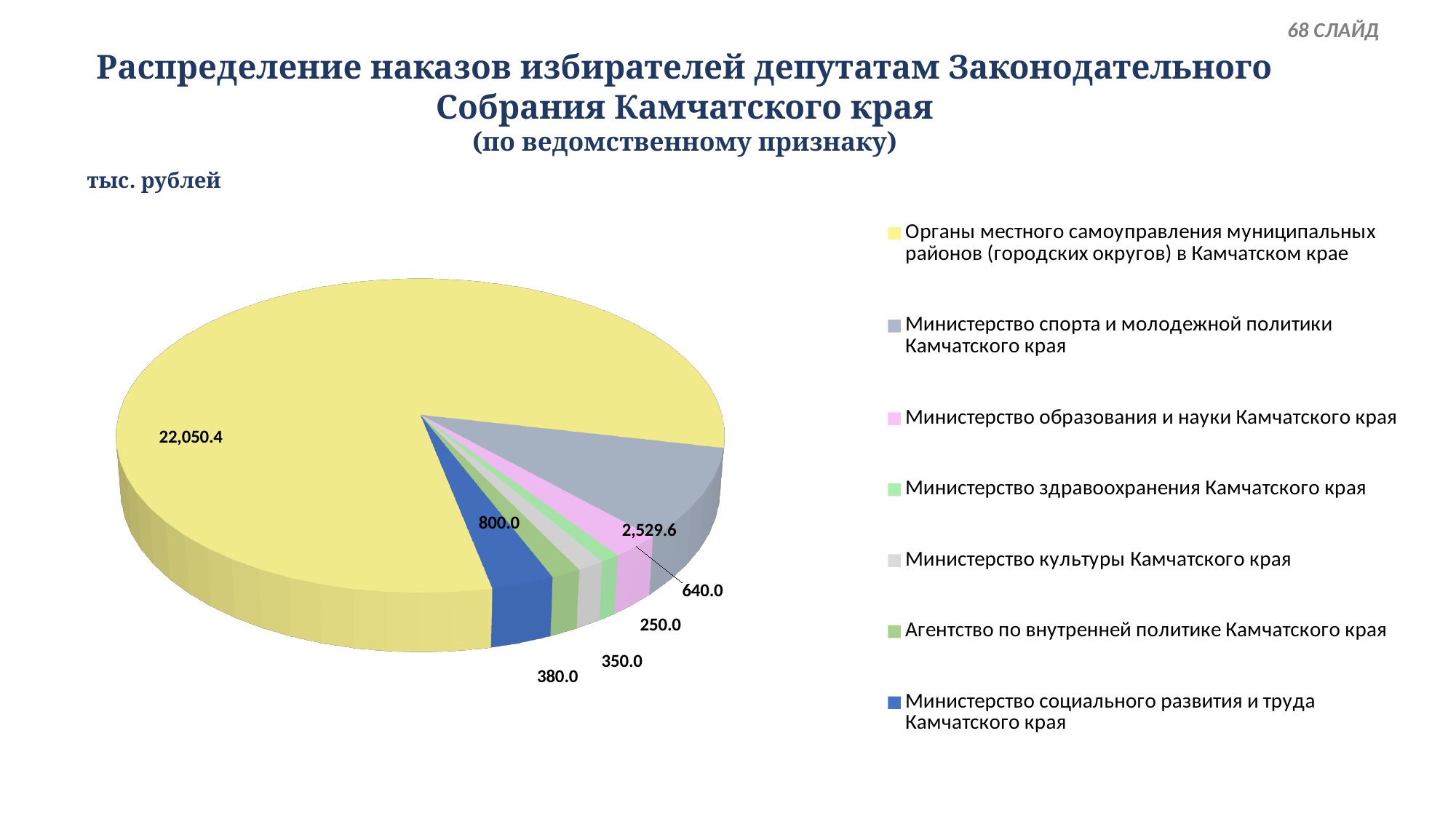
Which is larger: the value for Агентство по внутренней политике Камчатского края or the value for Министерство культуры Камчатского края? Агентство по внутренней политике Камчатского края What is the value for Министерство образования и науки Камчатского края? 640.0 What is the difference between the values for Министерство социального развития и труда Камчатского края and Министерство образования и науки Камчатского края? 160.0 What is the value for Органы местного самоуправления муниципальных районов (городских округов) в Камчатском крае? 22,050.4 What unit of measurement is stated for the chart values? тыс. рублей What is the value for Министерство социального развития и труда Камчатского края? 800.0 How many slices does the pie chart have? 7 What is the value for Министерство спорта и молодежной политики Камчатского края? 2,529.6 How many entries does the legend list? 7 What kind of chart is shown on the slide? Pie chart Which category has the smallest slice in the pie chart? Министерство здравоохранения Камчатского края Which category has the largest slice in the pie chart? Органы местного самоуправления муниципальных районов (городских округов) в Камчатском крае